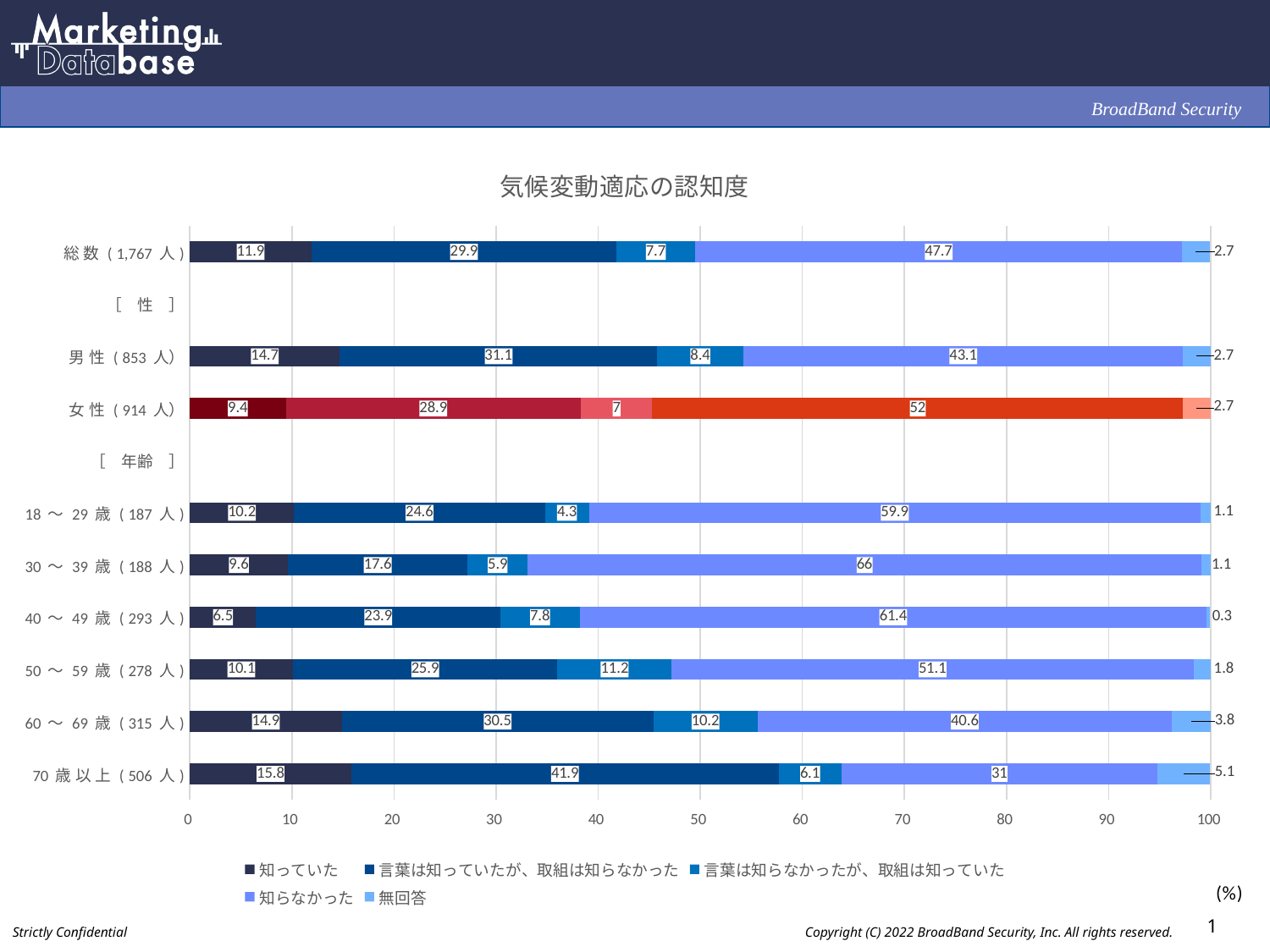
Which category has the lowest value for 無回答? 40〜49歳 (293人) What is the difference between the 知っていた values for 男性 (853人) and 女性 (914人)? 5.3 What is the value of 知らなかった for 総数 (1,767人)? 47.7 What type of chart is shown on the slide? stacked bar chart Which is larger, the 知らなかった value for 18〜29歳 (187人) or for 70歳以上 (506人)? 18〜29歳 (187人) What is the title of the chart? 気候変動適応の認知度 What is the value of 言葉は知らなかったが、取組は知っていた for 50〜59歳 (278人)? 11.2 Which age group has the highest value for 知らなかった? 30〜39歳 (188人) Which category has the highest value for 言葉は知っていたが、取組は知らなかった? 70歳以上 (506人) What is the value of 知っていた for 70歳以上 (506人)? 15.8 What is the value of 言葉は知っていたが、取組は知らなかった for 女性 (914人)? 28.9 How many series does the legend list? 5